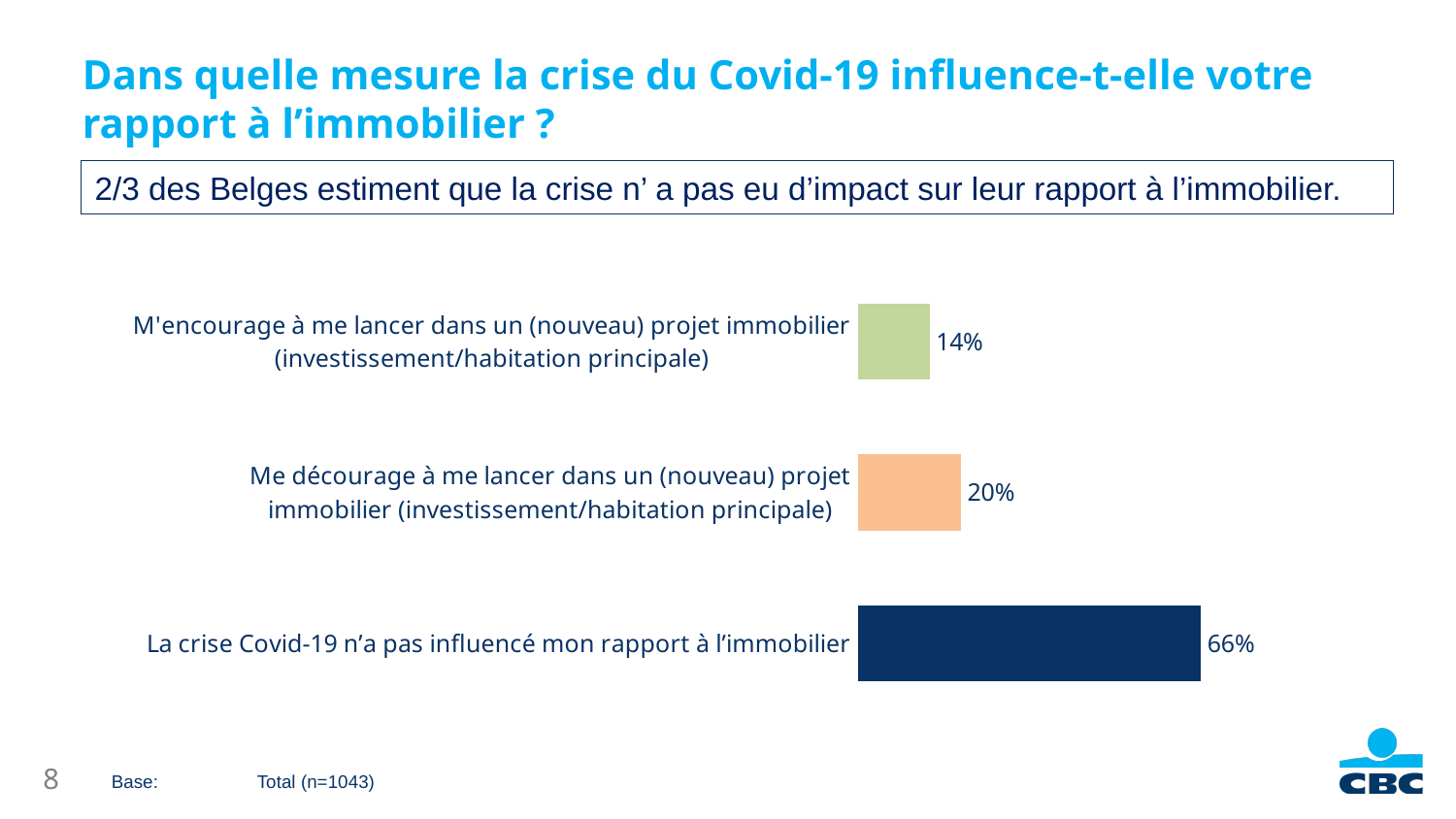
What kind of chart is shown on the slide? Bar chart What percentage of respondents say the Covid-19 crisis has not influenced their relationship to real estate? 66% What is the difference in percentage points between 'La crise Covid-19 n'a pas influencé mon rapport à l'immobilier' and 'Me décourage...'? 46 Which category has the lowest value in the chart? M'encourage à me lancer dans un (nouveau) projet immobilier (investissement/habitation principale) What is the difference in percentage points between 'Me décourage...' and 'M'encourage...'? 6 Which is larger: the value for 'Me décourage...' or the value for 'M'encourage...'? Me décourage à me lancer dans un (nouveau) projet immobilier (investissement/habitation principale) Which category has the highest value in the chart? La crise Covid-19 n'a pas influencé mon rapport à l'immobilier What percentage of respondents say the Covid-19 crisis discourages them from starting a (new) real estate project? 20% What percentage of respondents say the Covid-19 crisis encourages them to start a (new) real estate project? 14% What is the base (sample size) indicated at the bottom of the slide? Total (n=1043) What is the total of the three percentages shown in the chart? 100% How many categories are shown in the chart? 3